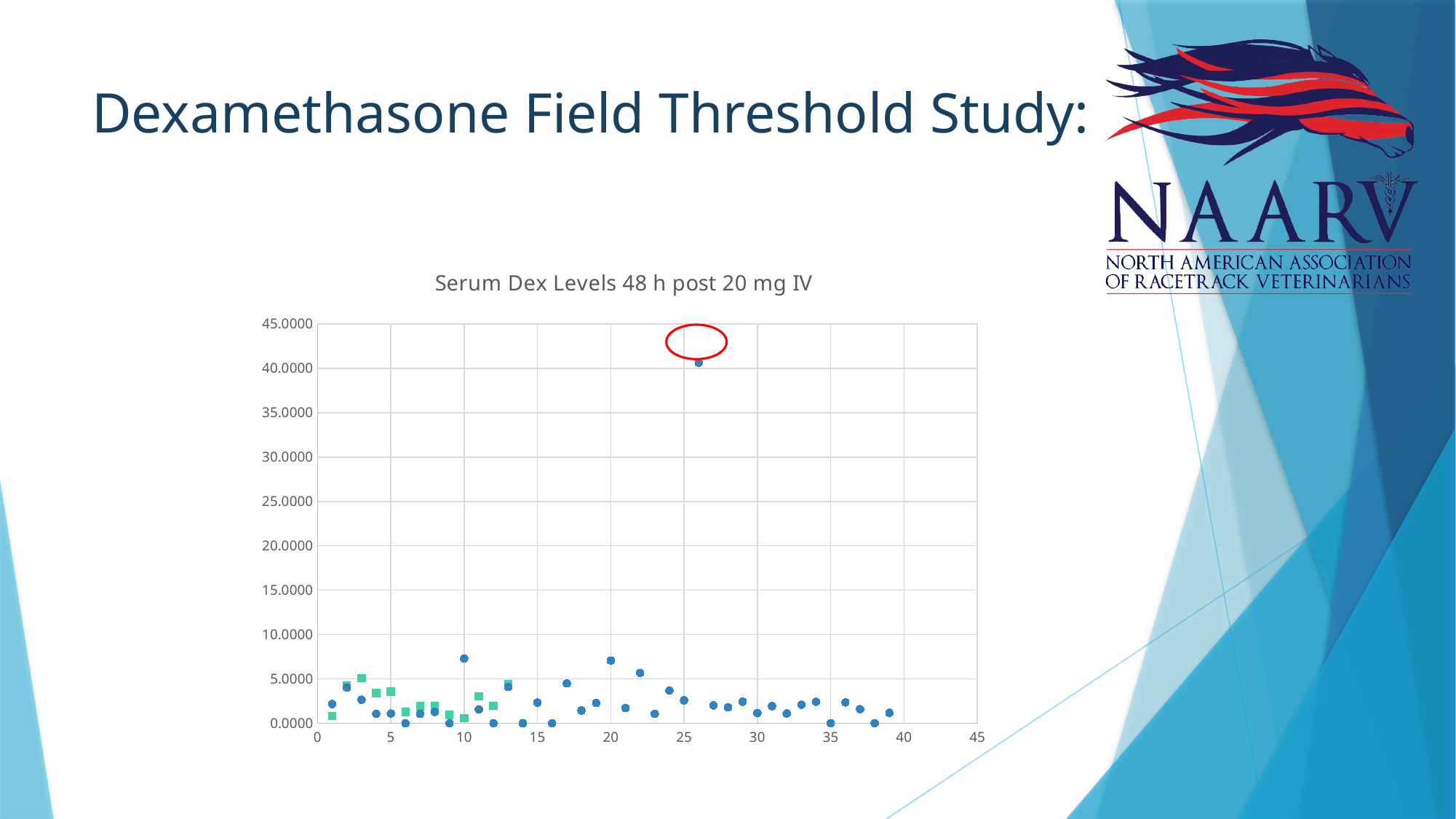
Is the value of the highest point on the chart greater or less than 30.0000? greater Is the highest point on the chart located between 25 and 30 on the horizontal axis, or between 35 and 40? between 25 and 30 What is the highest value shown on the chart's vertical axis? 45.0000 What kind of chart is shown on the slide? scatter chart What is the largest tick value shown on the horizontal axis? 45 Is the value of the highest point on the chart (the one circled in red) greater or less than 35.0000? greater Apart from the single outlier near the top, are all the other points on the chart above or below 10.0000? below What is the title of the chart? Serum Dex Levels 48 h post 20 mg IV